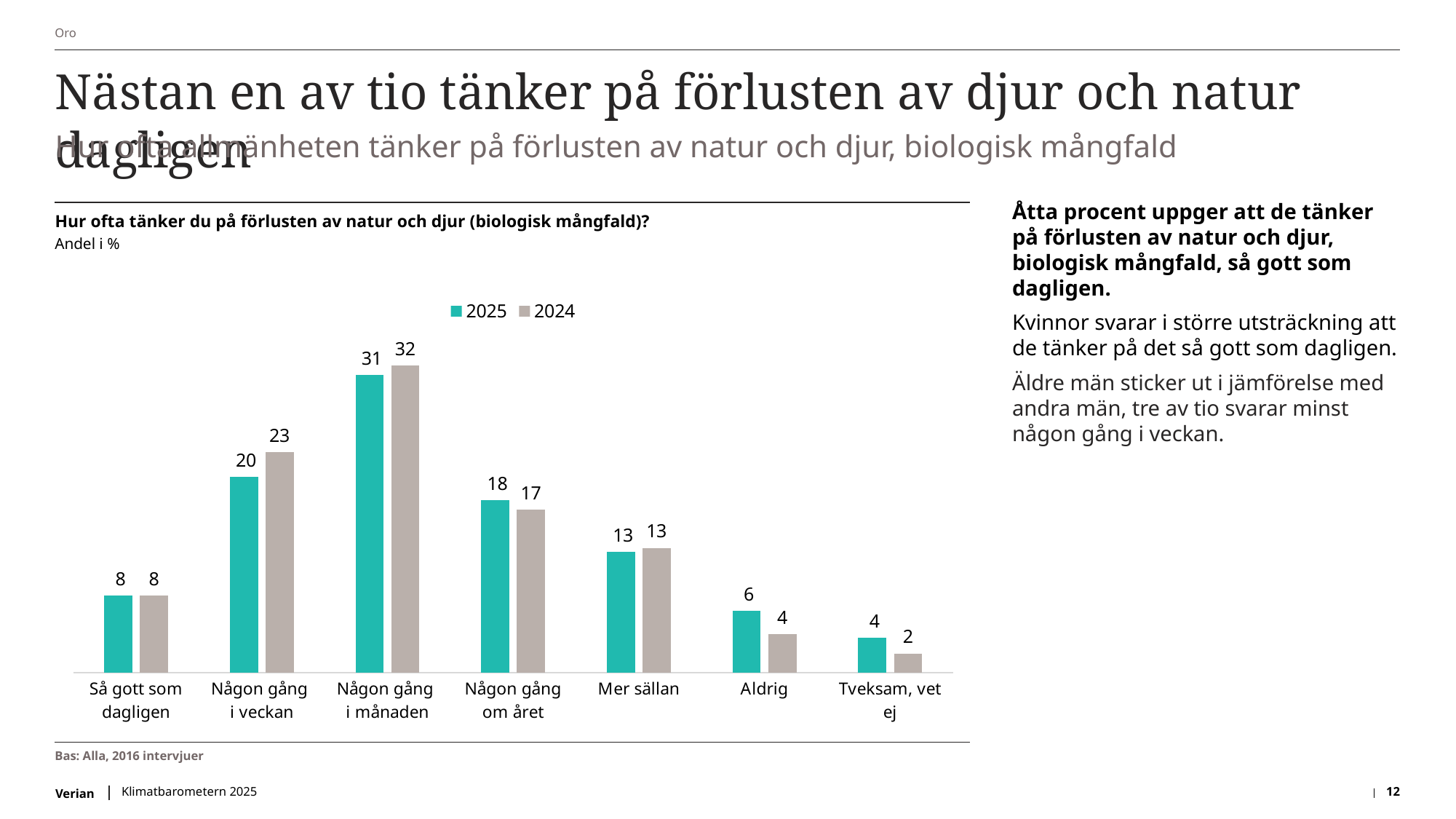
What is the 2025 value for "Någon gång i månaden"? 31 How many categories are shown on the x axis? 7 Which category has the lowest 2024 value? Tveksam, vet ej Which is larger for "Någon gång om året": the 2025 value or the 2024 value? 2025 Which category has the highest 2024 value? Någon gång i månaden What is the 2024 value for "Någon gång i veckan"? 23 What is the difference between the 2025 and 2024 values for "Aldrig"? 2 What is the 2025 value for "Så gott som dagligen"? 8 What is the difference between the 2024 values for "Någon gång i månaden" and "Någon gång i veckan"? 9 What kind of chart is shown on the slide? Bar chart Which series is shown in teal in the legend? 2025 How many series does the legend list? 2